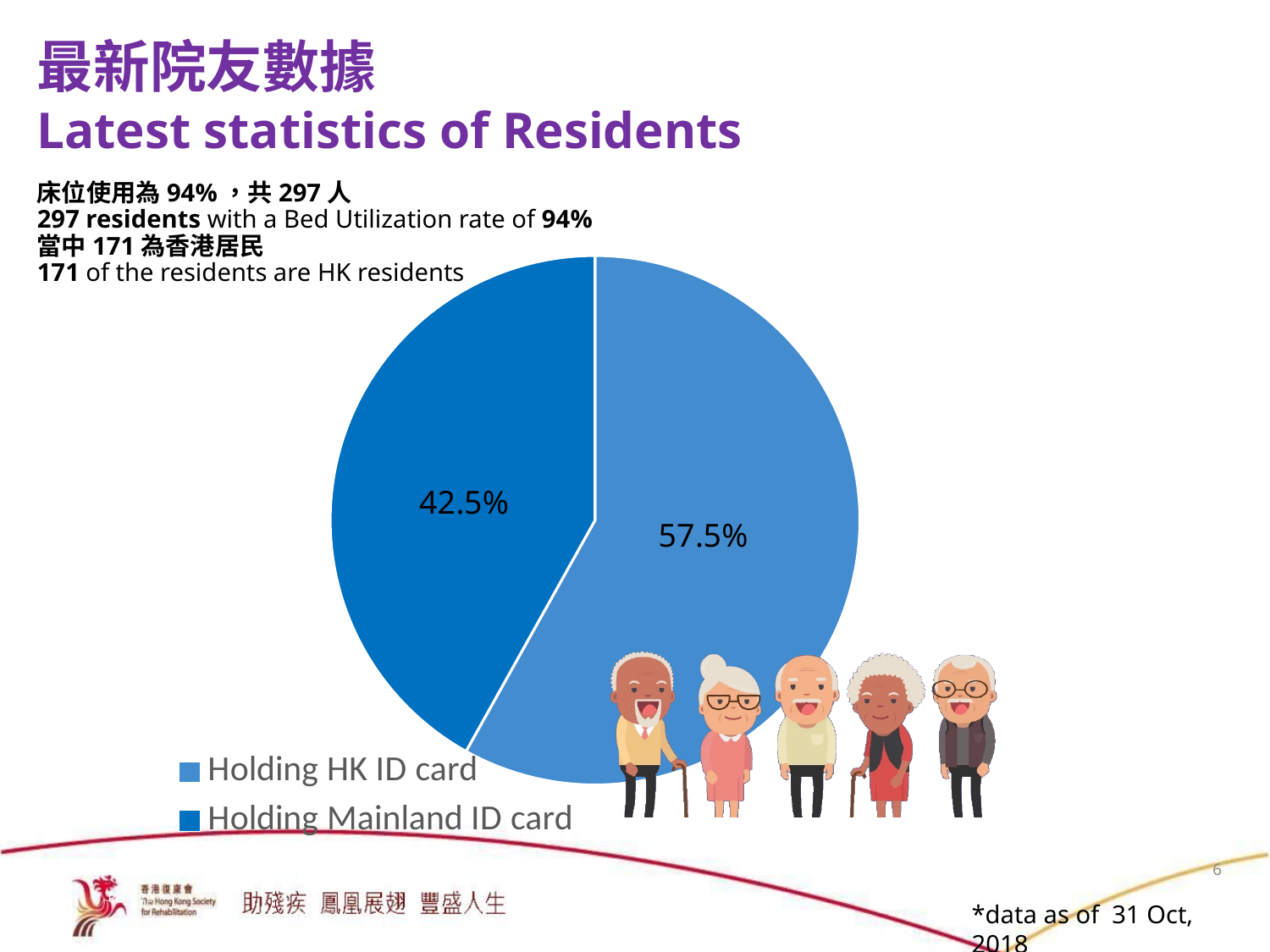
Is the share for Holding Mainland ID card greater or less than 50%? less Which category has the largest slice of the pie? Holding HK ID card What kind of chart is shown on the slide? Pie chart What share of the pie is labelled for residents holding a HK ID card? 57.5% How many entries does the legend list? 2 How many slices does the pie chart have? 2 Which category has the smallest slice of the pie? Holding Mainland ID card What share of the pie is labelled for residents holding a Mainland ID card? 42.5% What are the two legend entries of the pie chart? Holding HK ID card; Holding Mainland ID card Which legend entry is shown in the darker blue colour? Holding Mainland ID card Which is larger: the slice for Holding HK ID card or the slice for Holding Mainland ID card? Holding HK ID card What is the difference in percentage points between the HK ID card slice and the Mainland ID card slice? 15 percentage points